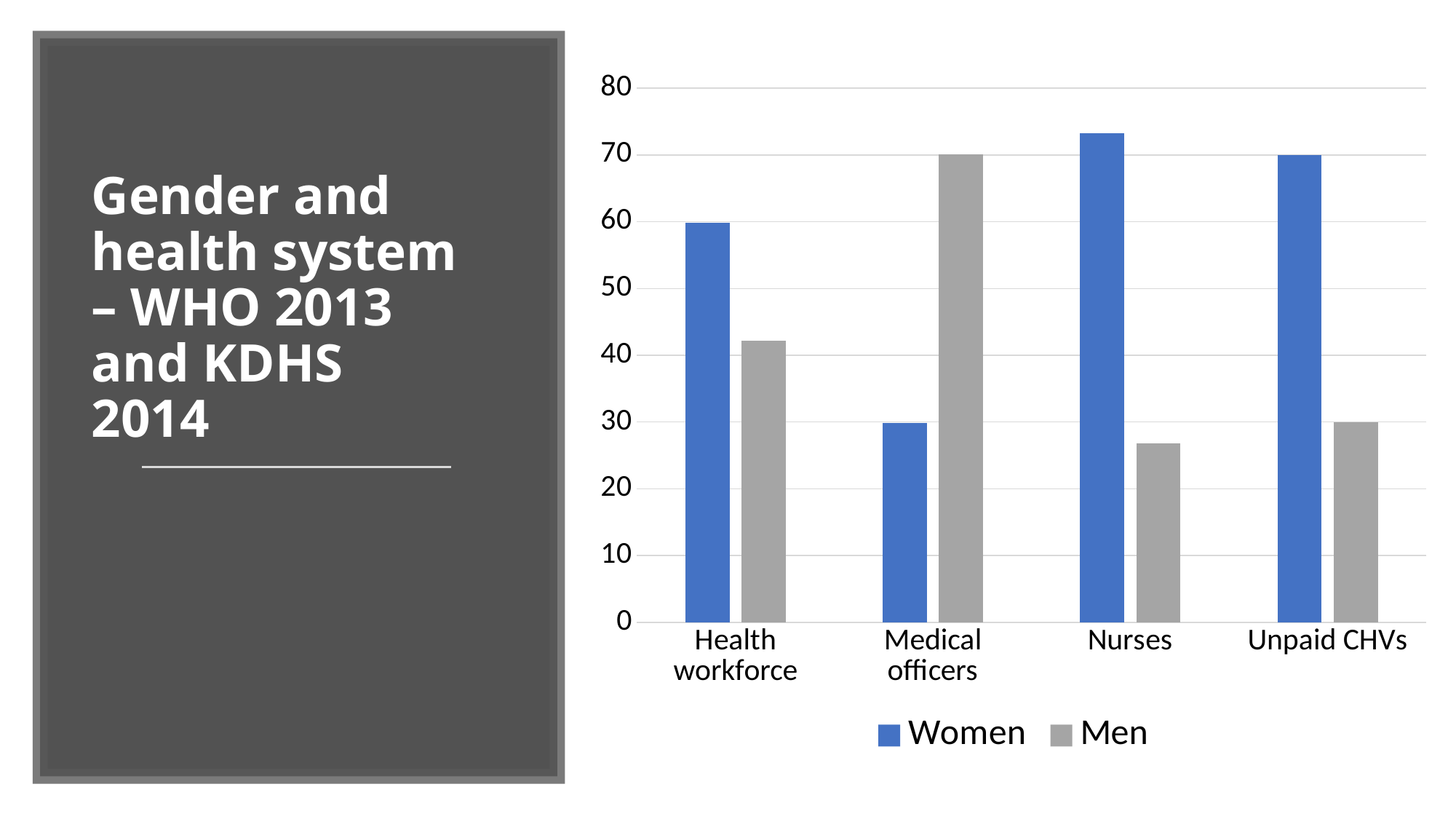
What kind of chart is shown on the slide? bar chart Which category has the lowest value for Women? Medical officers Is the value for Men in Nurses greater or less than 30? less For Medical officers, which is larger, the value for Women or the value for Men? Men Which category has the highest value for Men? Medical officers Which category has the highest value for Women? Nurses How many categories are shown on the x axis? 4 Is the value for Women in Health workforce greater or less than 50? greater Which series is shown in blue in the legend? Women Is the value for Men in Health workforce greater or less than 40? greater How many series does the legend list? 2 Which category has the lowest value for Men? Nurses